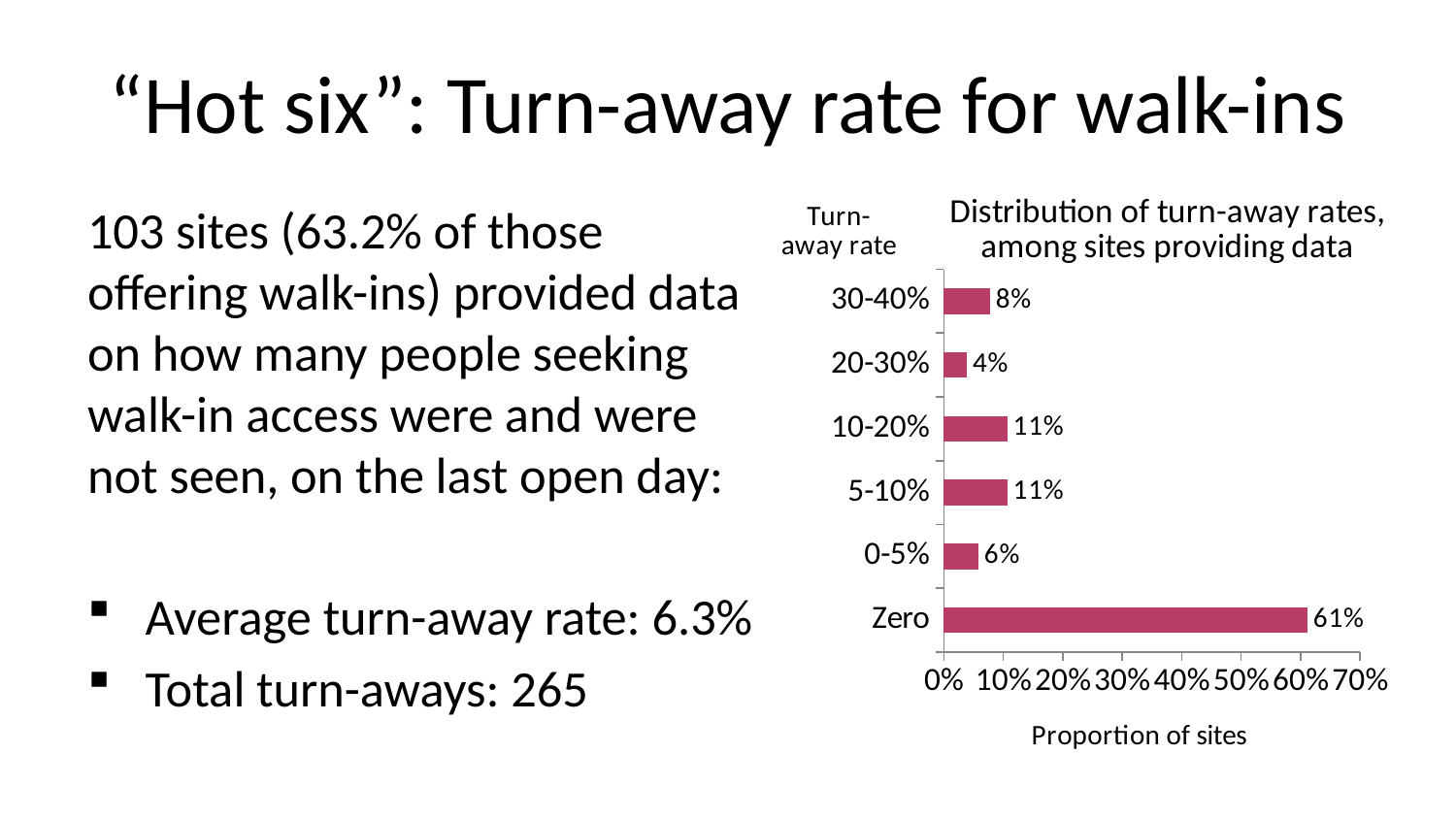
What proportion of sites had a turn-away rate of zero? 61% What is the difference in proportion of sites between the Zero category and the 10-20% category? 50% What is the title of the chart? Distribution of turn-away rates, among sites providing data Which turn-away rate category has the highest proportion of sites? Zero Which turn-away rate category has the lowest proportion of sites? 20-30% Is the proportion of sites in the Zero category greater or less than 50%? greater Which has a larger proportion of sites: the 30-40% category or the 0-5% category? 30-40% What type of chart is shown on the slide? Bar chart What proportion of sites had a turn-away rate of 30-40%? 8% What proportion of sites had a turn-away rate of 0-5%? 6% How many turn-away rate categories are shown in the chart? 6 What is the label of the horizontal axis of the chart? Proportion of sites